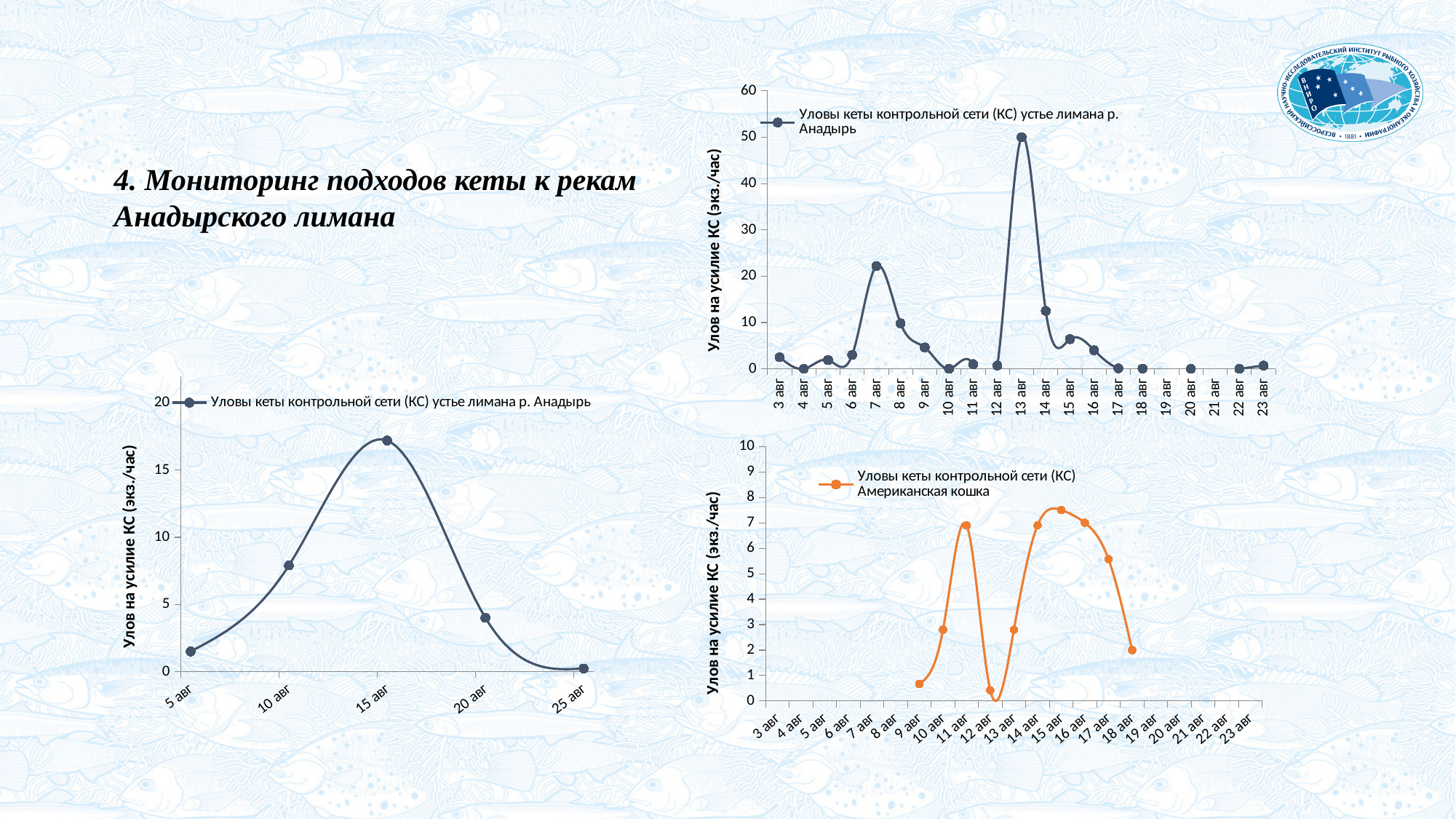
In the bottom-right chart, what series name does the legend show? Уловы кеты контрольной сети (КС) Американская кошка In the bottom-right chart, is the value for 11 авг greater or less than 5? greater In the chart on the left side of the slide, which is larger, the value for 10 авг or the value for 20 авг? 10 авг In the top-right chart, is the value for 7 авг greater or less than 10? greater In the chart on the left side of the slide, is the value for 10 авг greater or less than 10? less What kind of chart is the chart on the left side of the slide? line chart In the chart on the left side of the slide, how many data points are plotted? 5 In the top-right chart, which date has the highest value? 13 авг In the chart on the left side of the slide, which date has the highest value? 15 авг In the top-right chart, how many series does the legend list? 1